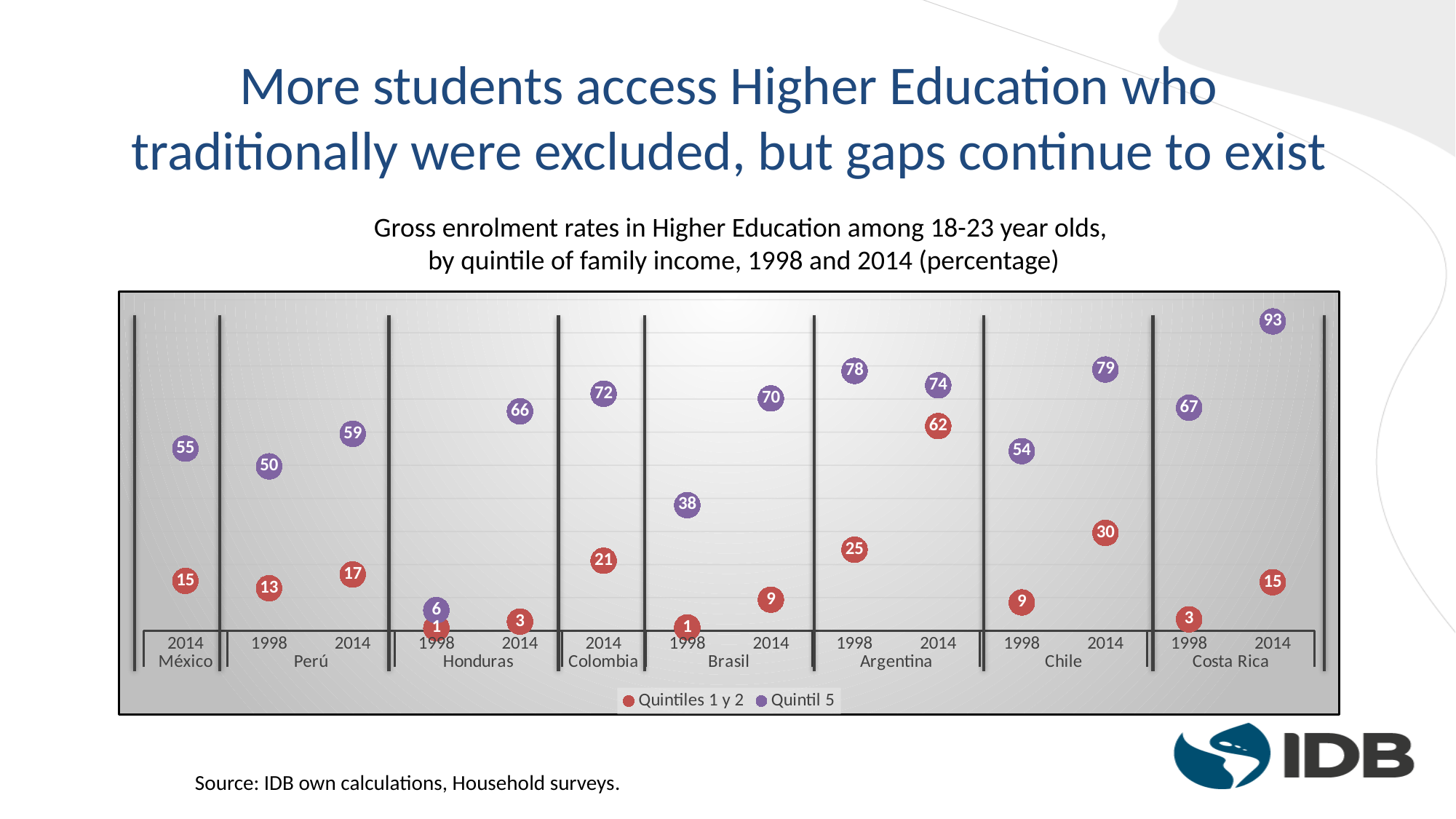
What is the Quintil 5 gross enrolment rate for Costa Rica in 2014? 93 How many countries are shown on the chart? 8 How many series does the legend list? 2 What is the lowest Quintiles 1 y 2 value shown on the chart? 1 What is the Quintiles 1 y 2 gross enrolment rate for Argentina in 2014? 62 What is the Quintil 5 value for Brasil in 1998? 38 Which country and year has the highest Quintil 5 value? Costa Rica 2014 Which is larger: the Quintil 5 value for Argentina in 1998 or in 2014? 1998 By how much did the Quintiles 1 y 2 value for Chile increase from 1998 to 2014? 21 What colour are the Quintil 5 markers on the chart? purple Did the Quintil 5 value for Honduras rise or fall from 1998 to 2014? rise What is the difference between the Quintil 5 and Quintiles 1 y 2 values for Colombia in 2014? 51